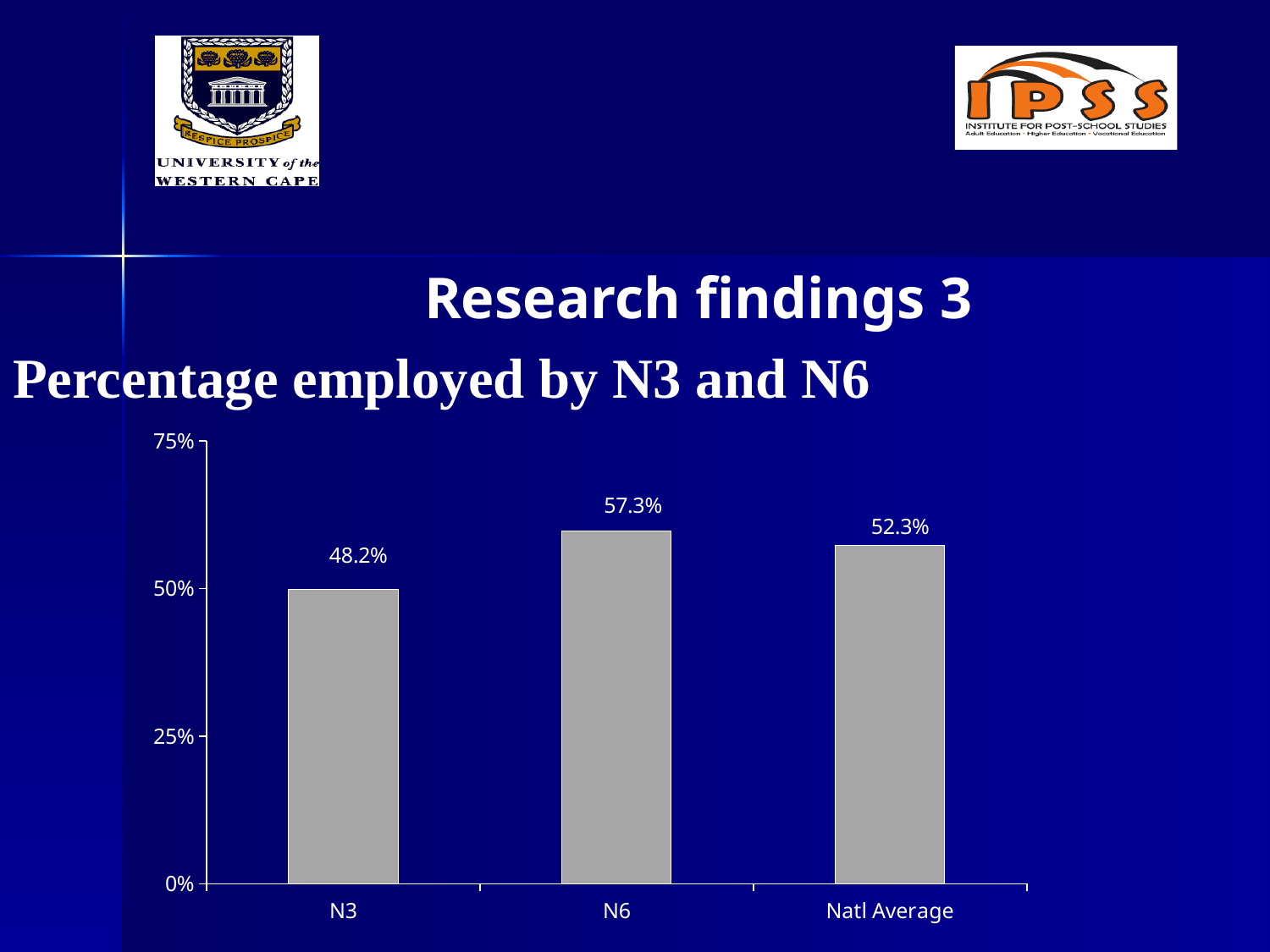
What is the value shown for Natl Average? 52.3% What kind of chart is shown on the slide? bar chart Which is larger, the value for N3 or the value for Natl Average? Natl Average Which category has the highest percentage employed? N6 What is the title of the chart? Percentage employed by N3 and N6 How many categories are shown on the x axis? 3 What is the difference between the N6 value and the Natl Average? 5.0% What is the difference in percentage employed between N6 and N3? 9.1% What is the percentage employed for N3? 48.2% Which category has the lowest percentage employed? N3 What is the percentage employed for N6? 57.3%